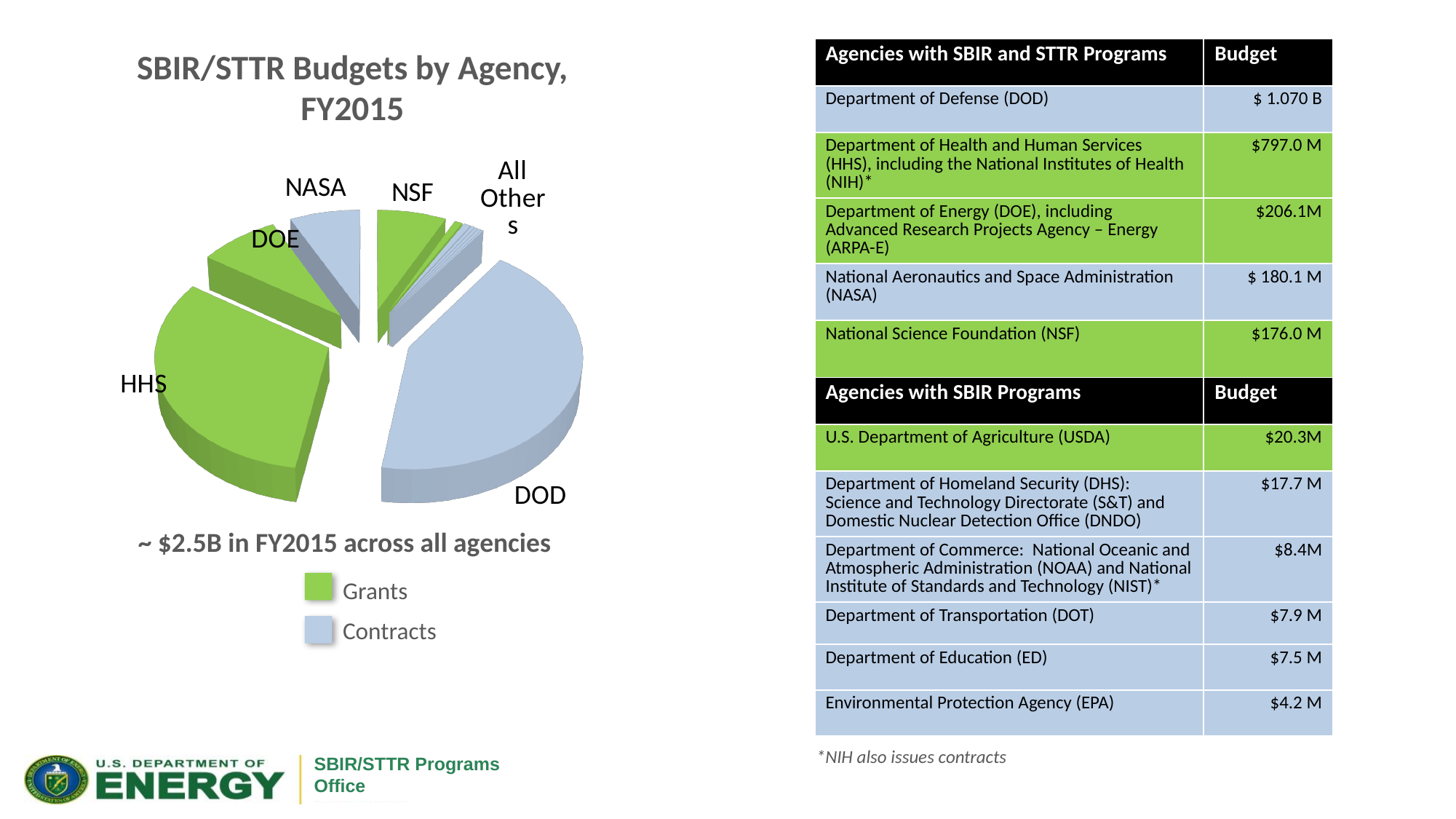
Which legend category does the HHS slice belong to? Grants How many labeled slices does the pie chart have? 6 Which slice is larger in the pie chart, HHS or NSF? HHS Which slice is larger in the pie chart, DOD or NASA? DOD Which slice is larger in the pie chart, HHS or DOE? HHS Which legend category does the DOD slice belong to? Contracts What is the title of the chart? SBIR/STTR Budgets by Agency, FY2015 What are the two legend entries of the pie chart? Grants, Contracts Which agency has the largest slice in the pie chart? DOD What kind of chart is shown on the slide? pie chart How many series does the legend list? 2